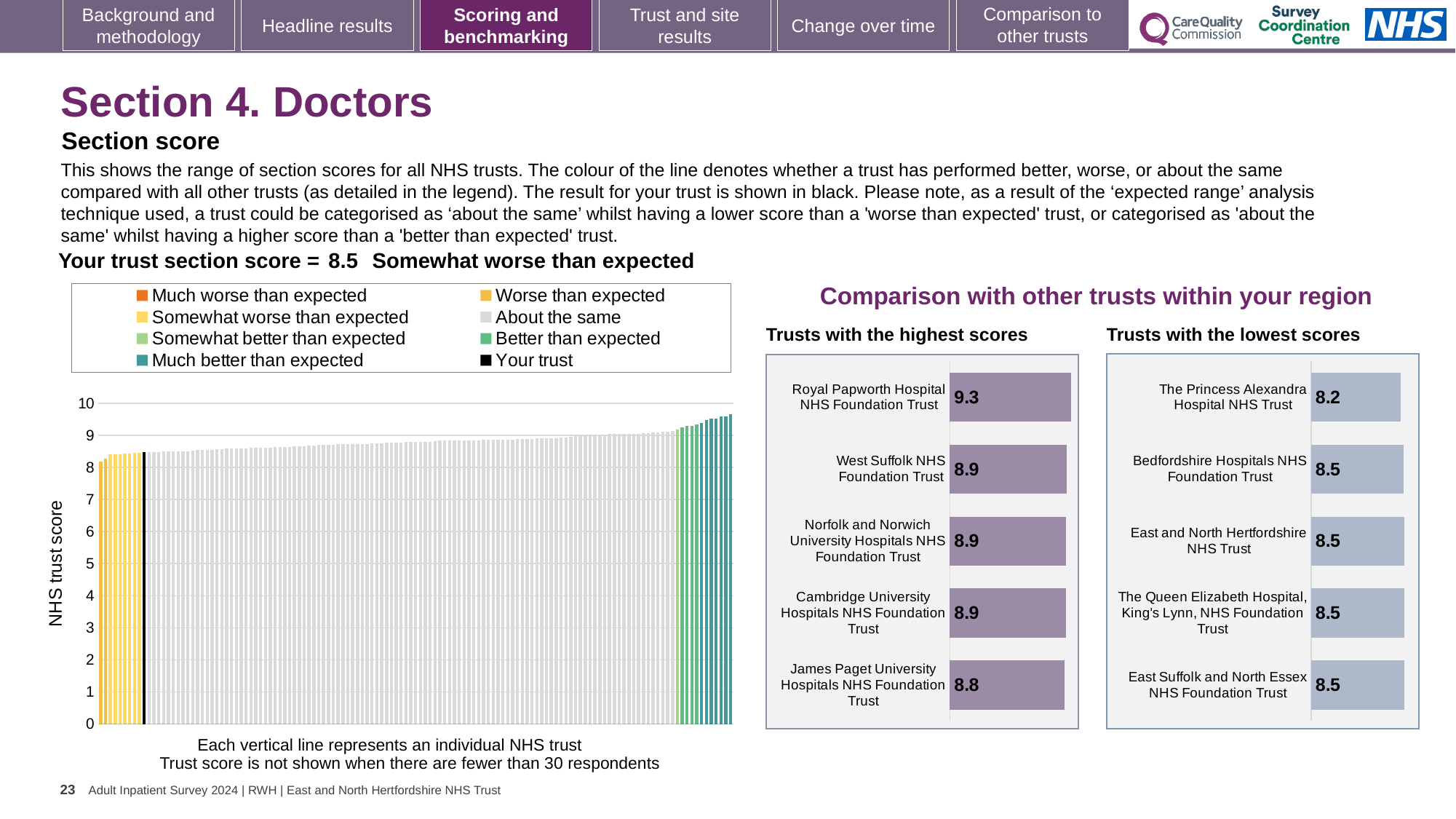
How many entries does the legend of the main chart on the left list? 8 In the 'Trusts with the highest scores' chart, which trust has the highest score? Royal Papworth Hospital NHS Foundation Trust In the 'Trusts with the highest scores' chart, what is the score for James Paget University Hospitals NHS Foundation Trust? 8.8 In the 'Trusts with the highest scores' chart, what is the score for Royal Papworth Hospital NHS Foundation Trust? 9.3 In the main chart of NHS trust scores on the left, do the values rise or fall from left to right along the x axis? rise In the 'Trusts with the highest scores' chart, what is the difference between the scores of Royal Papworth Hospital NHS Foundation Trust and James Paget University Hospitals NHS Foundation Trust? 0.5 In the 'Trusts with the lowest scores' chart, what is the score for East and North Hertfordshire NHS Trust? 8.5 In the 'Trusts with the lowest scores' chart, what is the score for The Princess Alexandra Hospital NHS Trust? 8.2 In the 'Trusts with the lowest scores' chart, which trust has the lowest score? The Princess Alexandra Hospital NHS Trust How many trusts are shown in the 'Trusts with the lowest scores' chart? 5 Which is larger: the score for Royal Papworth Hospital NHS Foundation Trust in the highest scores chart, or the score for The Princess Alexandra Hospital NHS Trust in the lowest scores chart? Royal Papworth Hospital NHS Foundation Trust In the main chart of NHS trust scores on the left, what is the section score for your trust? 8.5